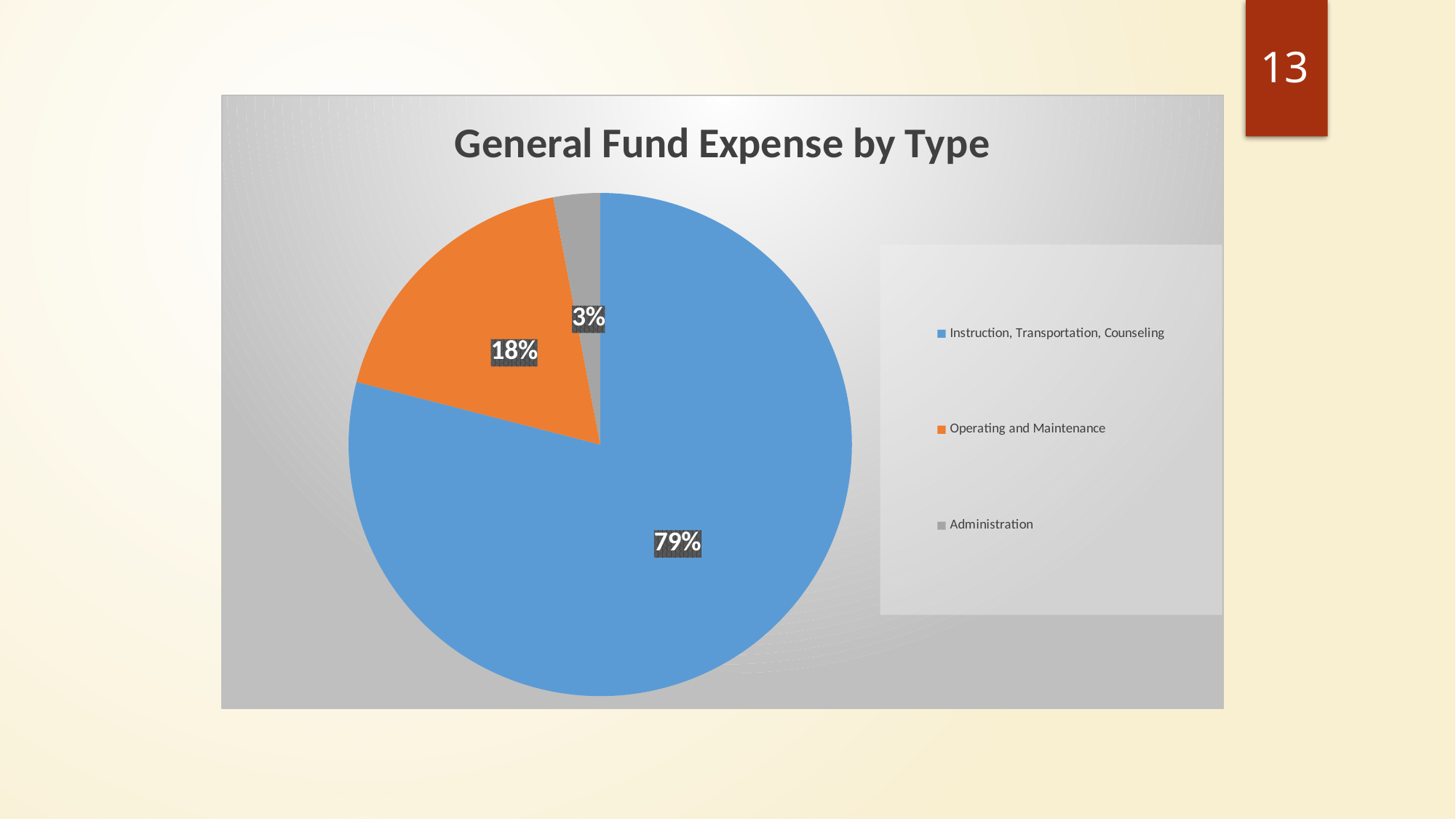
How many categories does the pie chart show? 3 Which is larger, the share for Operating and Maintenance or the share for Administration? Operating and Maintenance Which category has the smallest share of the pie? Administration What is the title of the chart? General Fund Expense by Type What is the difference in percentage points between Operating and Maintenance and Administration? 15 What colour is the Administration slice? grey Which category has the largest share of the pie? Instruction, Transportation, Counseling What share of the pie is Instruction, Transportation, Counseling? 79% What share of the pie is Administration? 3% What is the difference in percentage points between Instruction, Transportation, Counseling and Operating and Maintenance? 61 What kind of chart is shown on the slide? pie chart What share of the pie is Operating and Maintenance? 18%